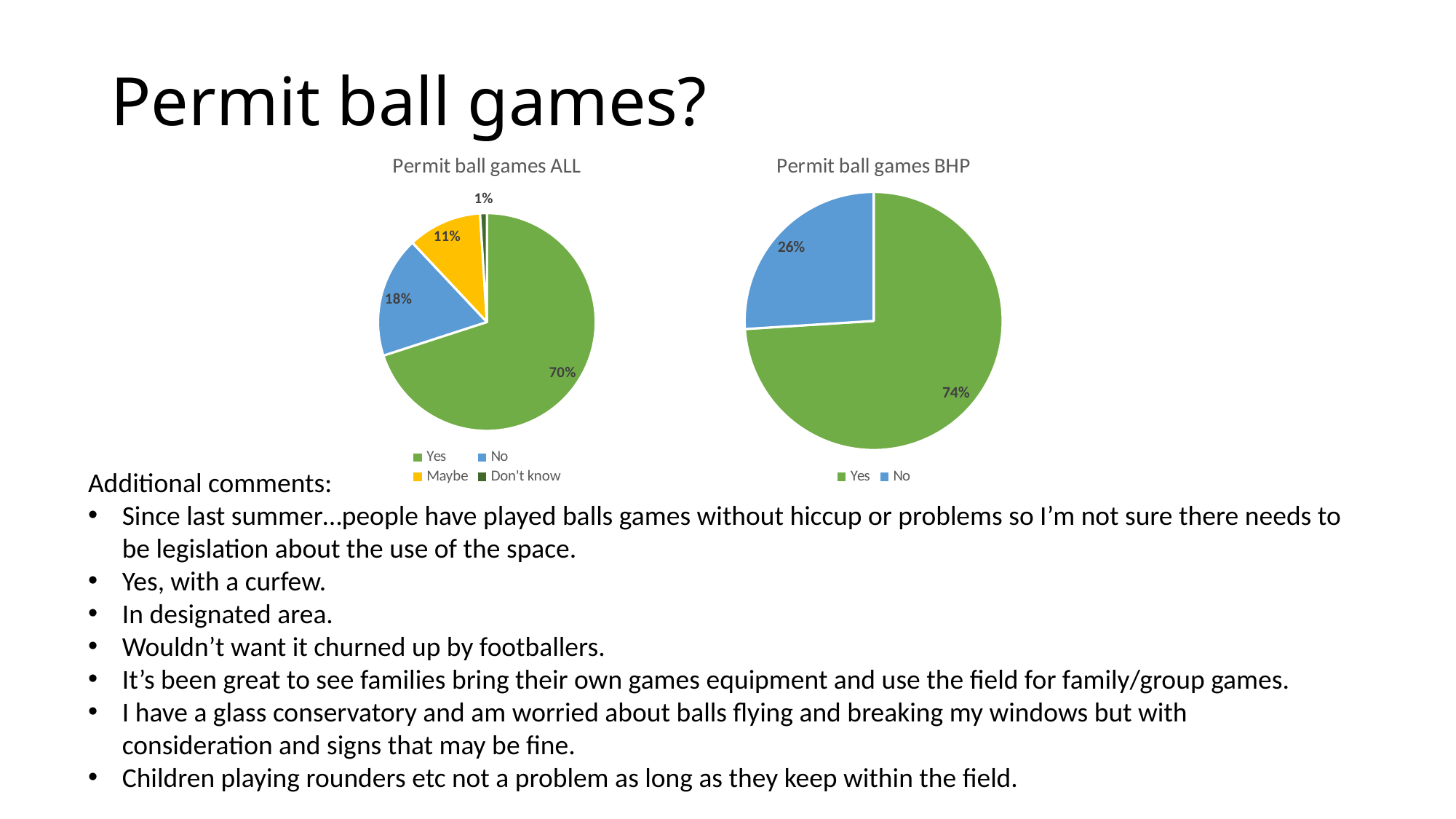
Is the 'Yes' share larger in the 'Permit ball games ALL' chart or the 'Permit ball games BHP' chart? Permit ball games BHP How many categories does the legend of the 'Permit ball games ALL' chart list? 4 In the 'Permit ball games ALL' chart, which category has the smallest share? Don't know In the 'Permit ball games ALL' chart, what share of responses is 'Yes'? 70% In the 'Permit ball games ALL' chart, what share of responses is 'No'? 18% In the 'Permit ball games ALL' chart, what share of responses is 'Maybe'? 11% In the 'Permit ball games BHP' chart, what share of responses is 'No'? 26% What kind of chart is 'Permit ball games BHP'? Pie chart In the 'Permit ball games ALL' chart, which category has the largest share? Yes In the 'Permit ball games BHP' chart, what share of responses is 'Yes'? 74% In the 'Permit ball games ALL' chart, what share of responses is 'Don't know'? 1% In the 'Permit ball games BHP' chart, what is the difference between the 'Yes' and 'No' shares? 48%